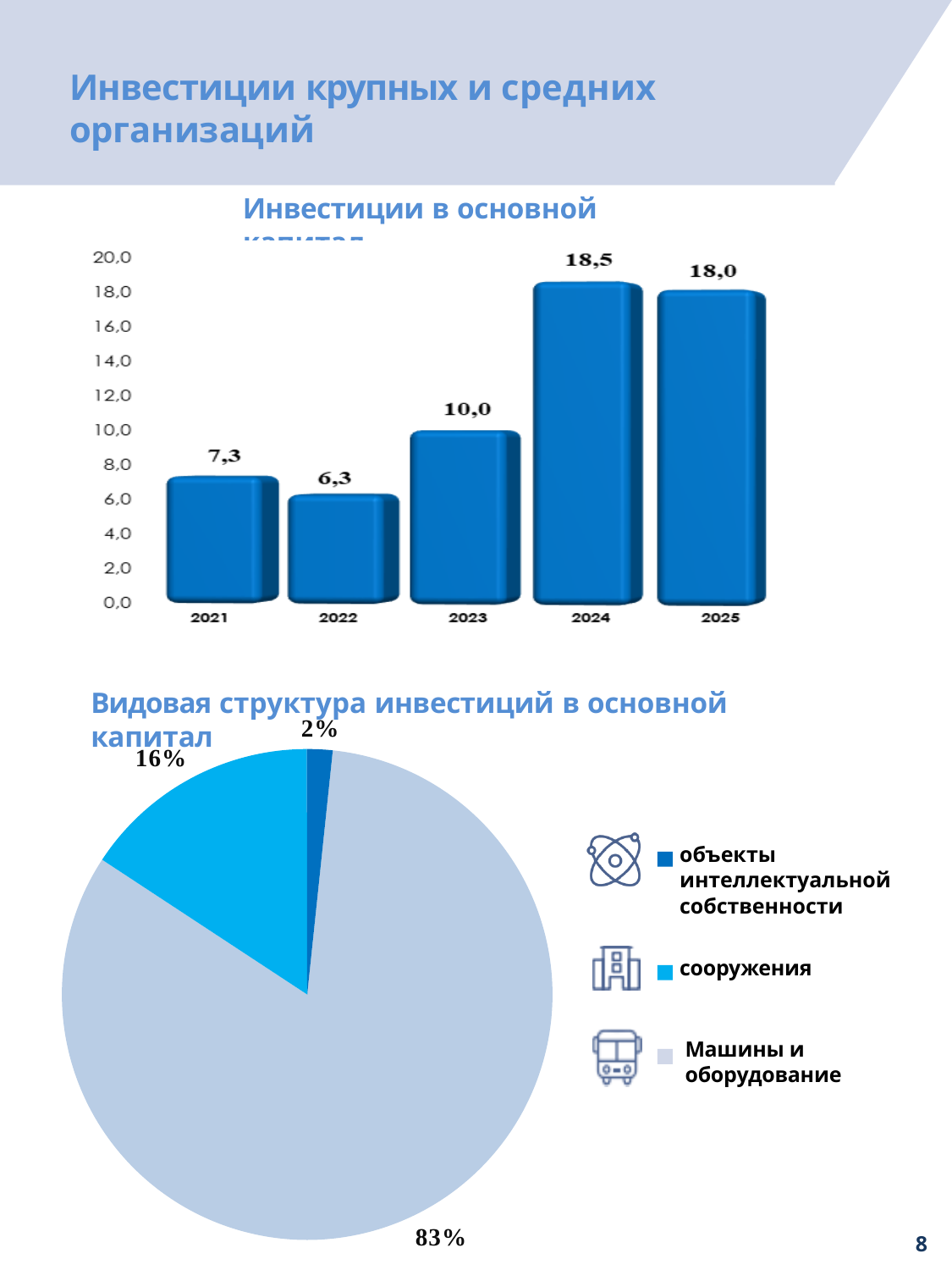
In the top bar chart, what is the value for 2024? 18,5 In the pie chart 'Видовая структура инвестиций в основной капитал', which category has the smallest share? объекты интеллектуальной собственности What kind of chart is the top chart on the slide? bar chart In the top bar chart, which year has the lowest value? 2022 How many years are shown in the top bar chart? 5 In the top bar chart, what is the value for 2021? 7,3 In the pie chart 'Видовая структура инвестиций в основной капитал', what share is 'сооружения'? 16% In the top bar chart, which is larger, the value for 2021 or the value for 2022? 2021 How many categories does the legend of the pie chart 'Видовая структура инвестиций в основной капитал' list? 3 In the pie chart 'Видовая структура инвестиций в основной капитал', what share is 'Машины и оборудование'? 83% In the top bar chart, which year has the highest value? 2024 In the top bar chart, what is the difference between the values for 2024 and 2023? 8,5